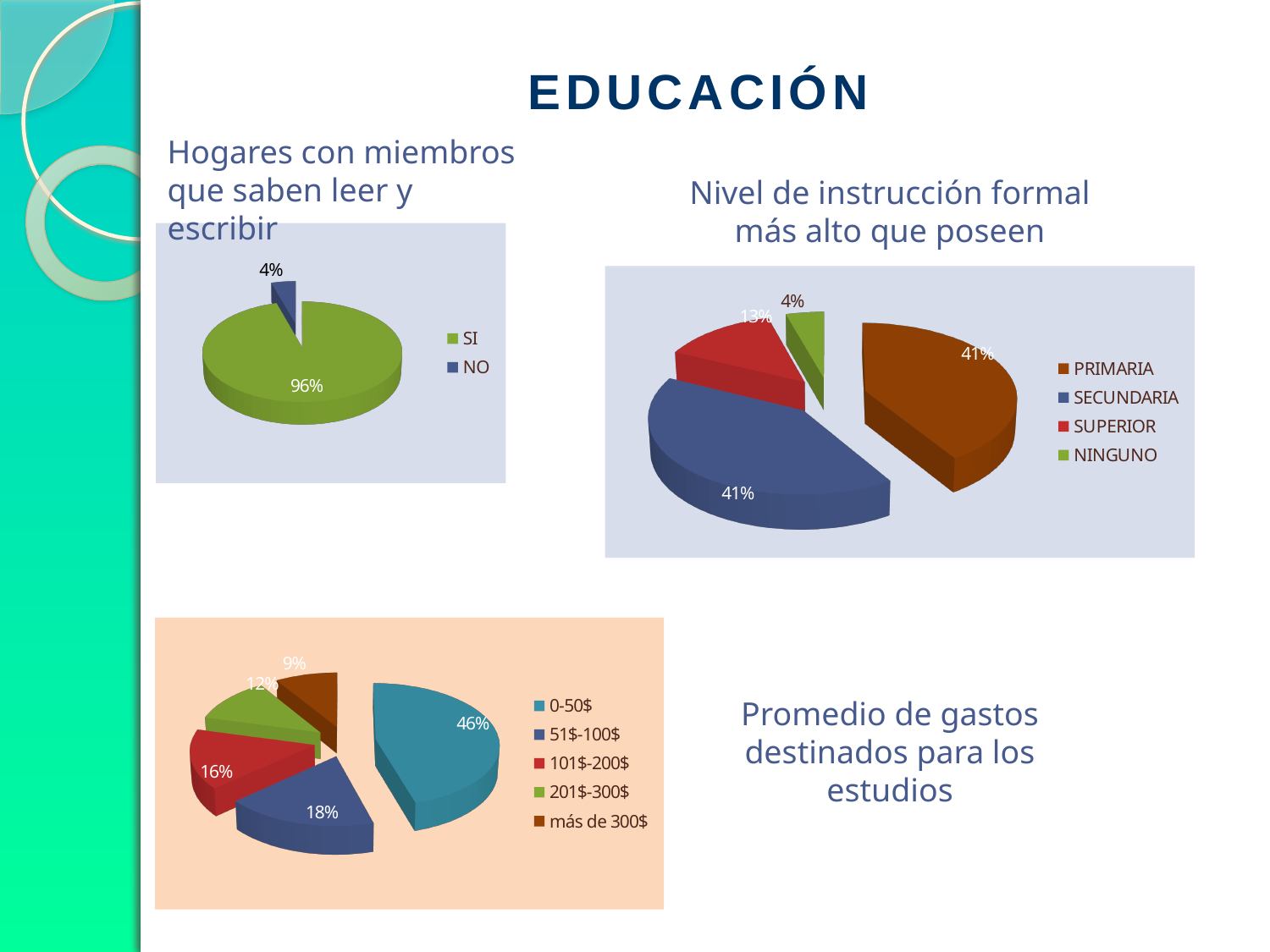
In the chart 'Nivel de instrucción formal más alto que poseen', how many categories does the legend list? 4 In the chart 'Promedio de gastos destinados para los estudios', which category has the smallest share? más de 300$ In the chart 'Nivel de instrucción formal más alto que poseen', what is the difference between the SUPERIOR and NINGUNO shares? 9% In the chart 'Hogares con miembros que saben leer y escribir', what percentage is shown for NO? 4% In the chart 'Hogares con miembros que saben leer y escribir', what percentage is shown for SI? 96% In the chart 'Promedio de gastos destinados para los estudios', which is larger: 51$-100$ or 101$-200$? 51$-100$ In the chart 'Nivel de instrucción formal más alto que poseen', what percentage is shown for SUPERIOR? 13% What kind of chart is 'Hogares con miembros que saben leer y escribir'? Pie chart In the chart 'Nivel de instrucción formal más alto que poseen', which category has the smallest share? NINGUNO In the chart 'Promedio de gastos destinados para los estudios', how many categories does the legend list? 5 In the chart 'Promedio de gastos destinados para los estudios', what percentage is shown for 0-50$? 46% In the chart 'Promedio de gastos destinados para los estudios', which category has the largest share? 0-50$